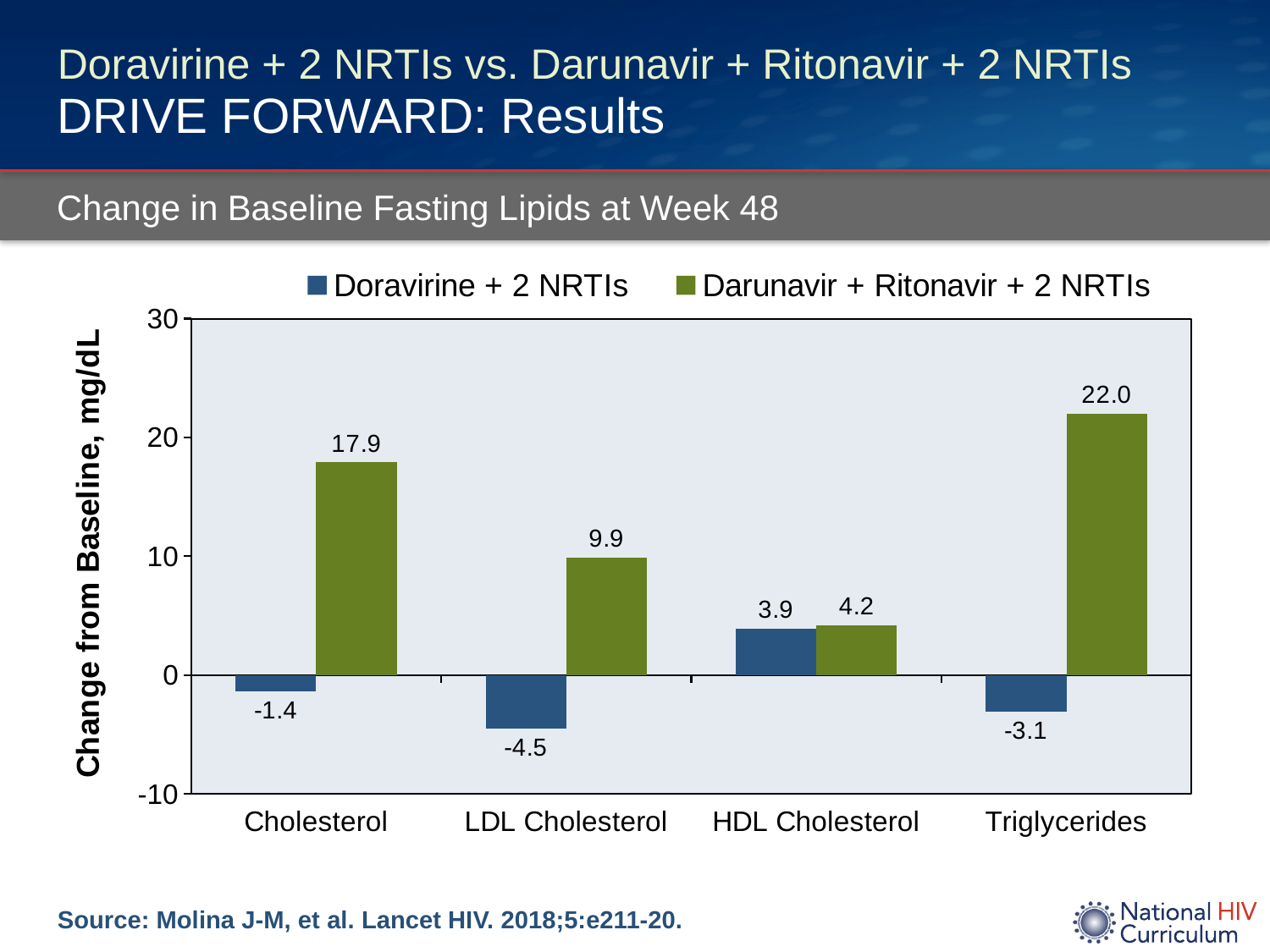
What is the difference between the Darunavir + Ritonavir + 2 NRTIs and Doravirine + 2 NRTIs values for cholesterol? 19.3 What is the change from baseline in cholesterol for Doravirine + 2 NRTIs? -1.4 What is the change from baseline in HDL cholesterol for Doravirine + 2 NRTIs? 3.9 What is the label of the y axis? Change from Baseline, mg/dL How many series does the legend list? 2 Which lipid category has the highest change from baseline for Darunavir + Ritonavir + 2 NRTIs? Triglycerides What kind of chart is shown on the slide? Bar chart Which lipid category has the lowest change from baseline for Doravirine + 2 NRTIs? LDL Cholesterol How many lipid categories are shown on the x axis? 4 What is the change from baseline in LDL cholesterol for Darunavir + Ritonavir + 2 NRTIs? 9.9 What is the change from baseline in triglycerides for Darunavir + Ritonavir + 2 NRTIs? 22.0 Which series has the larger change from baseline in LDL cholesterol? Darunavir + Ritonavir + 2 NRTIs